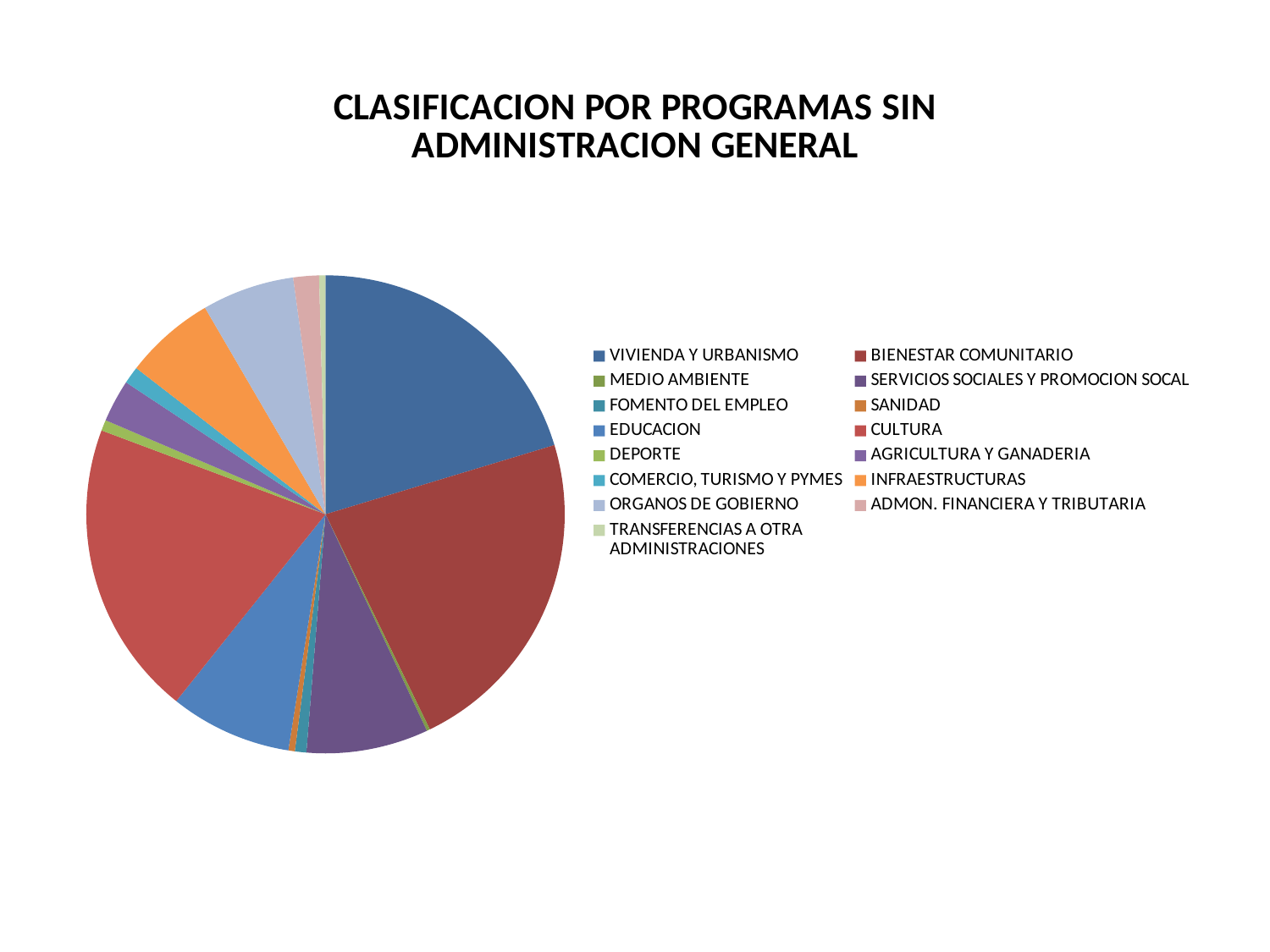
Which slice is larger, INFRAESTRUCTURAS or SANIDAD? INFRAESTRUCTURAS Which slice is larger, ORGANOS DE GOBIERNO or AGRICULTURA Y GANADERIA? ORGANOS DE GOBIERNO What is the title of the chart? CLASIFICACION POR PROGRAMAS SIN ADMINISTRACION GENERAL Which slice is larger, CULTURA or SERVICIOS SOCIALES Y PROMOCION SOCAL? CULTURA What kind of chart is shown on the slide? pie chart How many categories does the legend of the pie chart list? 15 Which category has the largest slice of the pie chart? BIENESTAR COMUNITARIO What colour is the VIVIENDA Y URBANISMO slice in the pie chart? blue